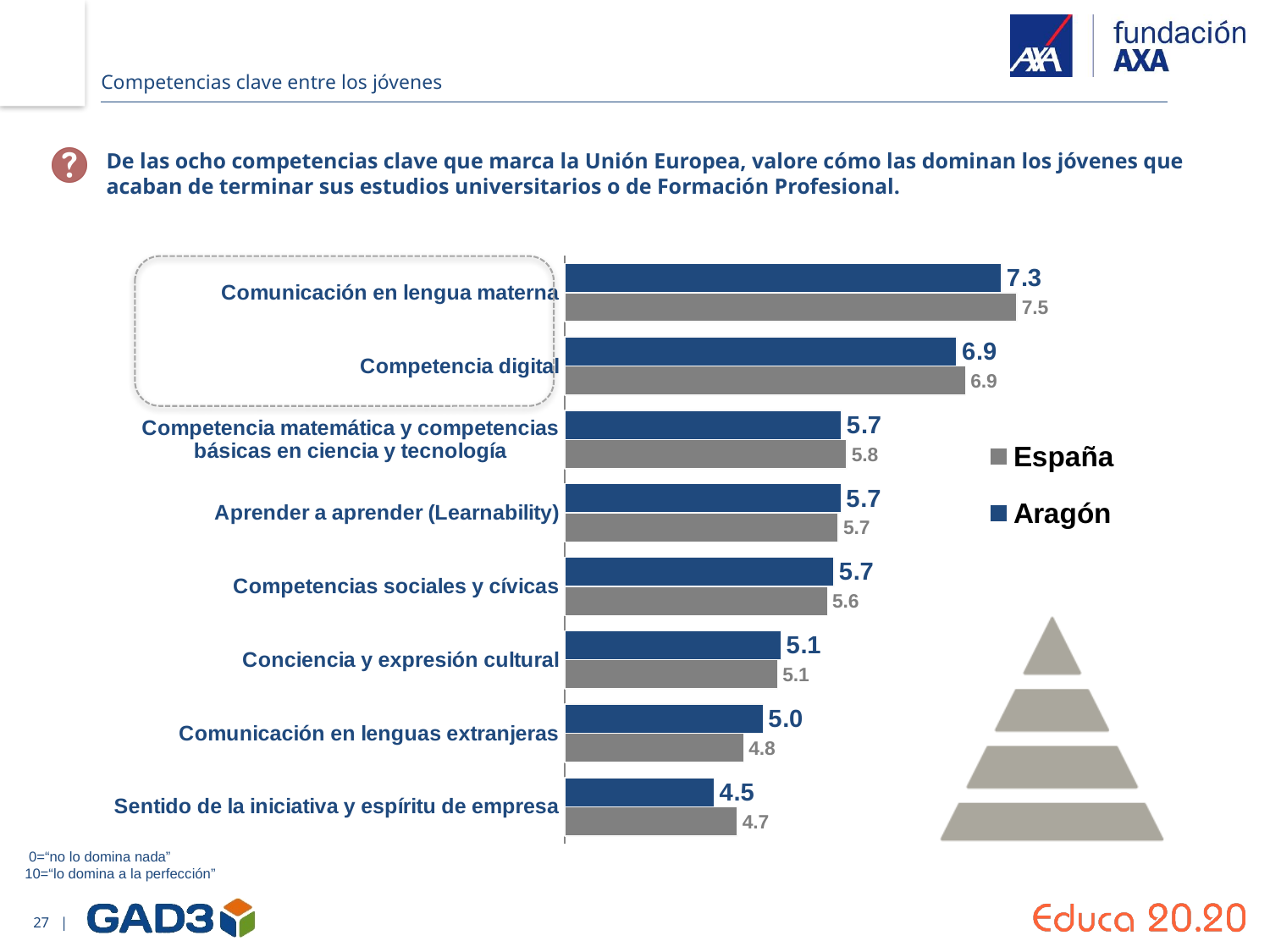
How many categories are shown in the chart? 8 Which category has the lowest value for España? Sentido de la iniciativa y espíritu de empresa What is the value for España for Comunicación en lenguas extranjeras? 4.8 Which category has the highest value for Aragón? Comunicación en lengua materna What is the value for Aragón for Comunicación en lengua materna? 7.3 Which is larger for Comunicación en lenguas extranjeras, the Aragón value or the España value? Aragón How many series does the legend list? 2 What is the difference between the España and Aragón values for Comunicación en lengua materna? 0.2 What is the value for España for Comunicación en lengua materna? 7.5 What kind of chart is shown on the slide? Bar chart Which series is shown in grey in the legend? España What is the value for Aragón for Sentido de la iniciativa y espíritu de empresa? 4.5